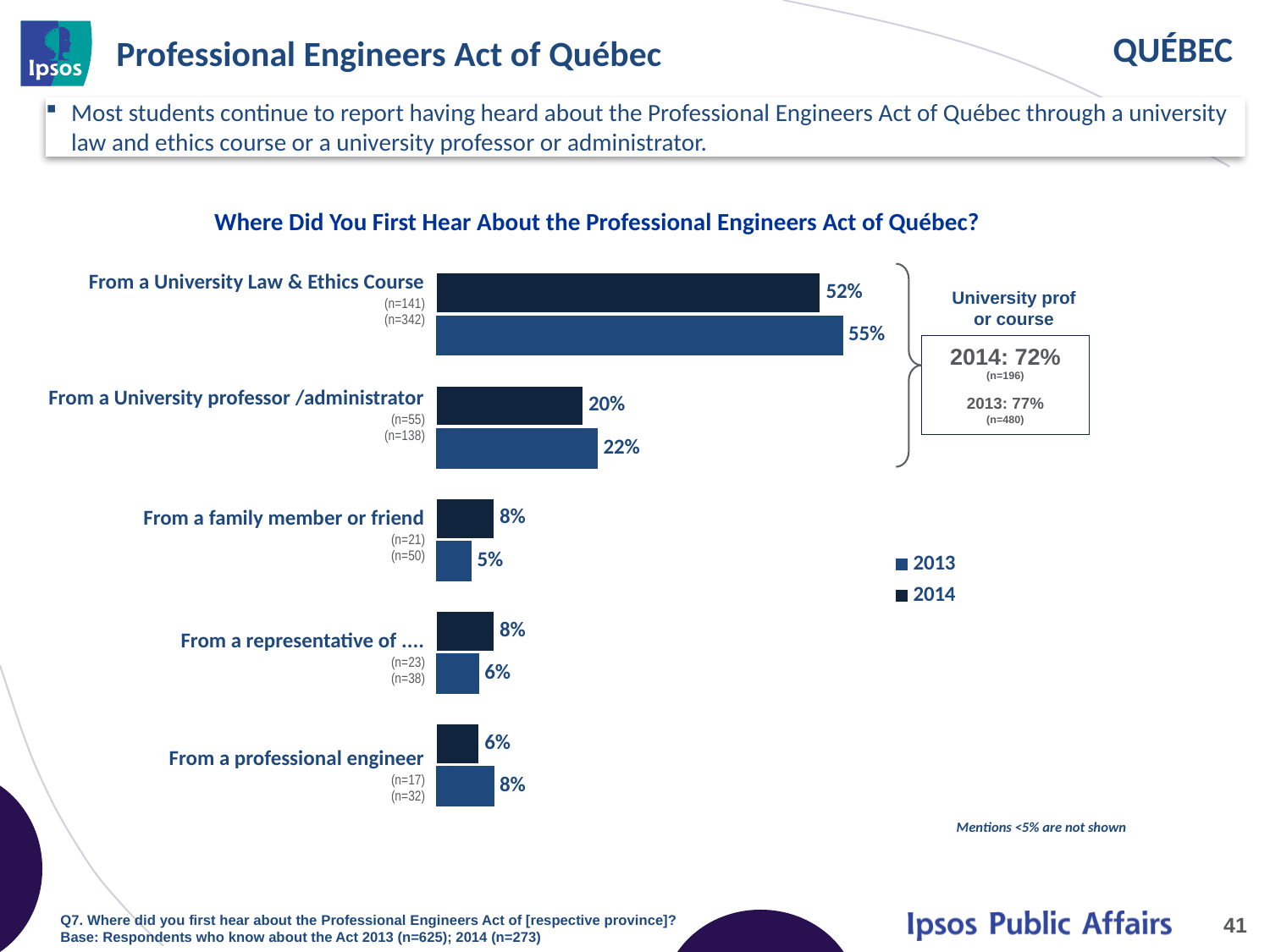
How many categories (sources) are shown in the chart? 5 What value is shown on the lighter (lower) bar for 'From a University Law & Ethics Course'? 55% What value is shown on the darker (upper) bar for 'From a University Law & Ethics Course'? 52% What kind of chart is shown on the slide? Bar chart What value is shown on the lighter (lower) bar for 'From a family member or friend'? 5% What is the difference between the two bars for 'From a University Law & Ethics Course' (55% and 52%)? 3 percentage points What two entries does the chart legend list? 2013 and 2014 What value is shown on the darker (upper) bar for 'From a University professor /administrator'? 20% Which category has the highest values in the chart? From a University Law & Ethics Course How many series does the chart legend list? 2 According to the 'University prof or course' callout, what is the combined value for 2014? 72% For 'From a professional engineer', which bar is larger, the darker (upper) bar or the lighter (lower) bar? The lighter (lower) bar, 8%